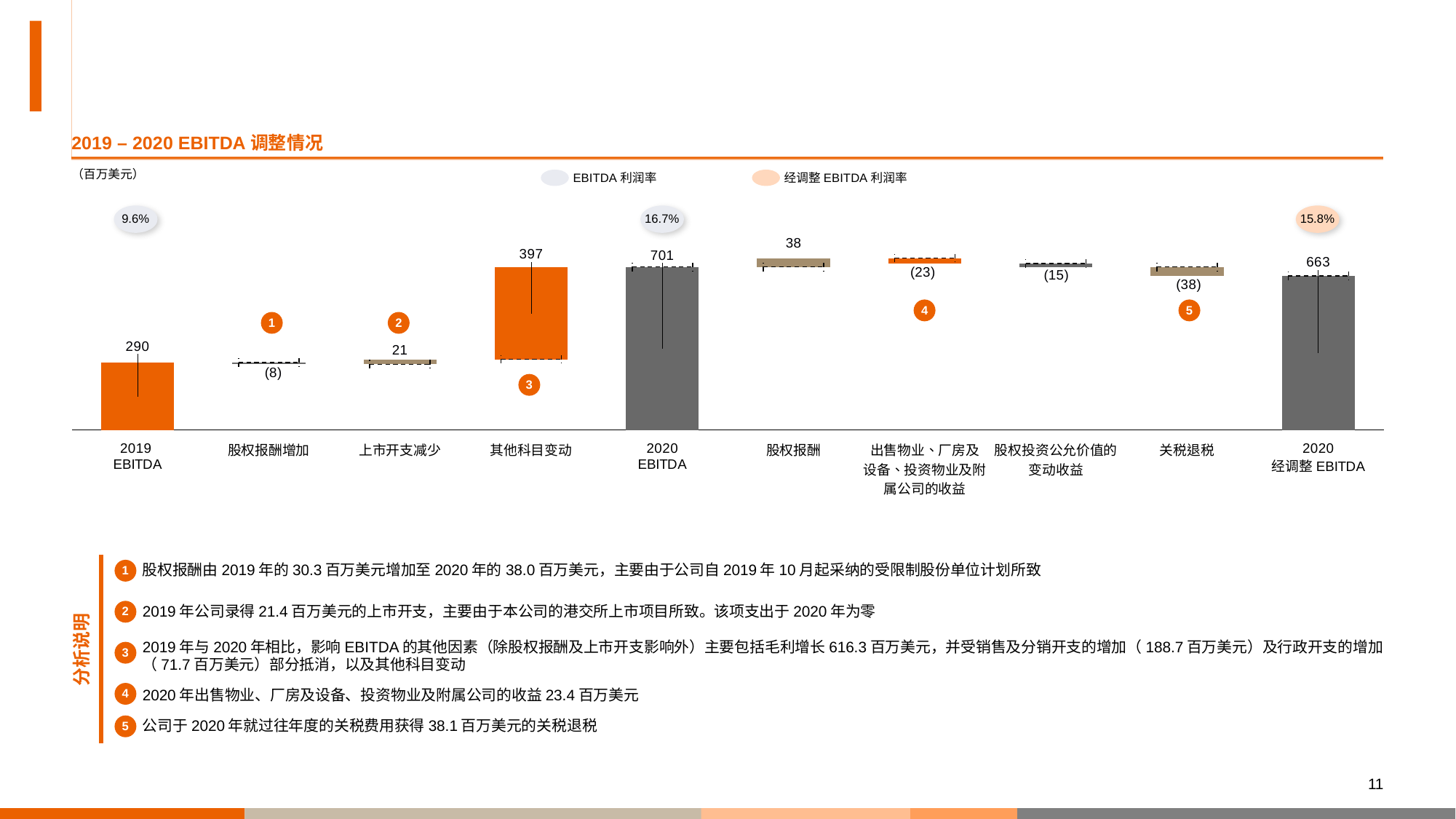
What is the value for 2019 EBITDA? 290 What EBITDA margin is shown above the 2019 EBITDA bar? 9.6% Which category has the highest bar value? 2020 EBITDA What is the value for 2020 经调整 EBITDA? 663 What is the value shown for 关税退税? (38) How many categories are shown on the x axis? 10 What is the value for 2020 EBITDA? 701 What is the value shown for 其他科目变动? 397 Which is larger, 2020 EBITDA or 2020 经调整 EBITDA? 2020 EBITDA What is the difference between 2020 EBITDA and 2019 EBITDA? 411 How many entries does the legend list? 2 What adjusted EBITDA margin is shown above the 2020 经调整 EBITDA bar? 15.8%